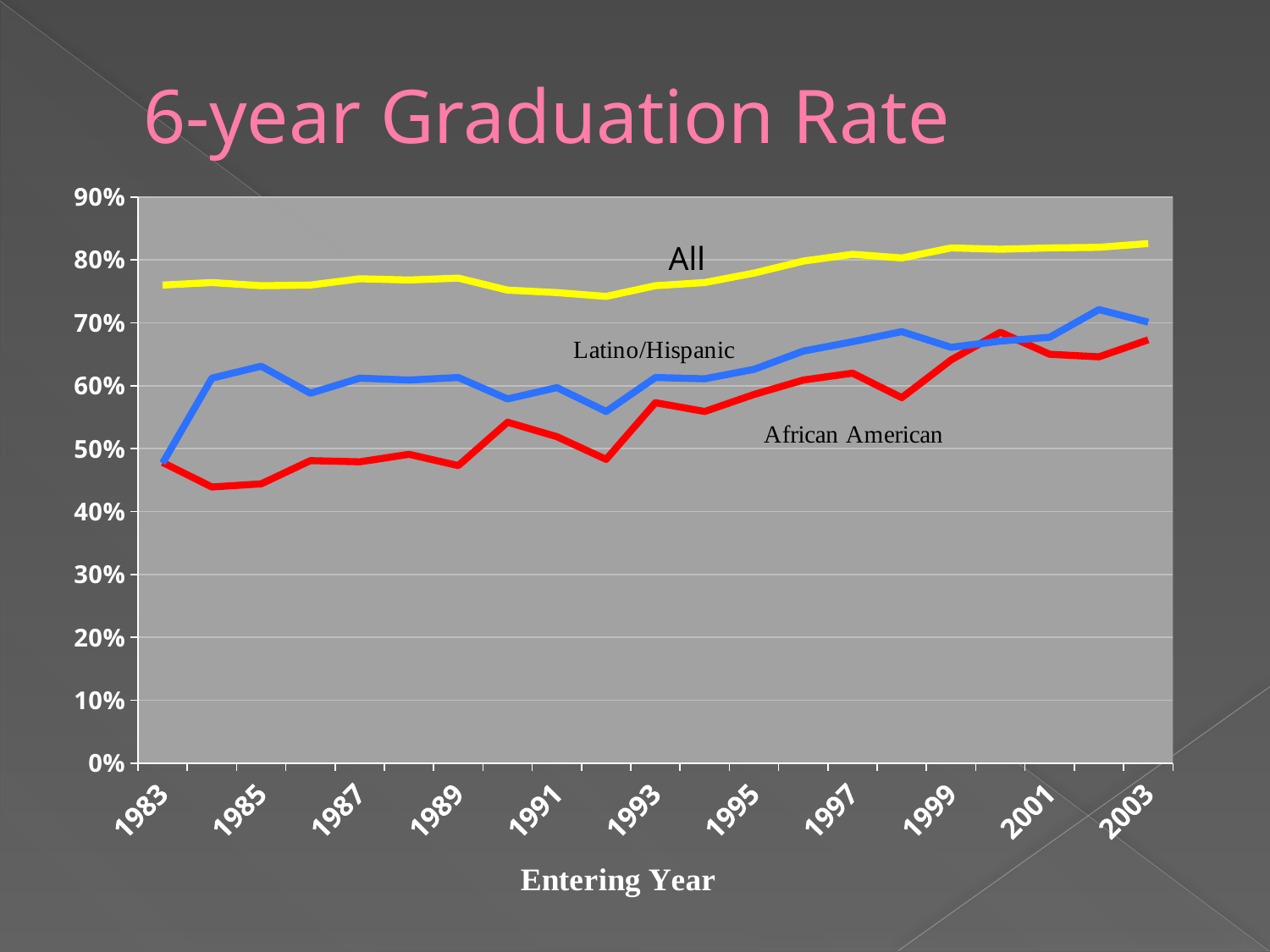
Does the All series generally rise or fall from 1983 to 2003? rise How many series are plotted on the chart? 3 Which series has the highest value in 2003? All Is the value for All in 1983 greater or less than 70%? greater Is the value for Latino/Hispanic in 1985 greater or less than 60%? greater What is the label of the x axis? Entering Year What kind of chart is shown on the slide? line chart What is the title of the chart? 6-year Graduation Rate Is the value for All in 2003 greater or less than 80%? greater Which series has the lowest value in 1985? African American